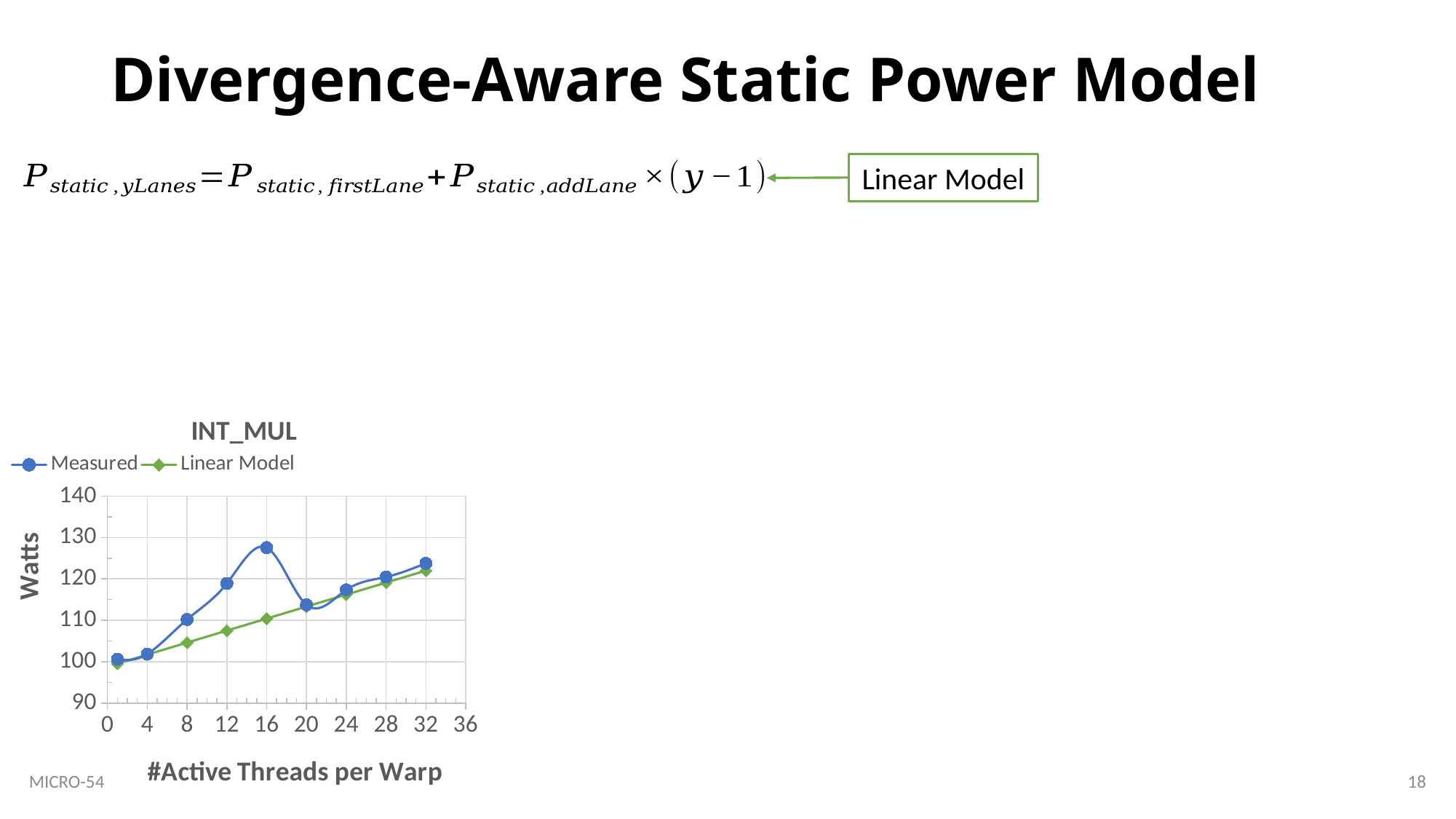
Is the Measured value at 16 active threads per warp greater or less than 120? greater Do the Linear Model values rise or fall as the number of active threads per warp increases? rise What kind of chart is the INT_MUL chart? line chart At 16 active threads per warp, which series has the larger value, Measured or Linear Model? Measured How many series does the legend of the INT_MUL chart list? 2 Is the Measured value at 20 active threads per warp greater or less than 120? less What is the label of the y axis of the INT_MUL chart? Watts What is the title of the chart on the slide? INT_MUL How many data points are plotted for the Measured series in the INT_MUL chart? 9 Is the Linear Model value at 8 active threads per warp greater or less than 110? less At which number of active threads per warp does the Measured series reach its highest value? 16